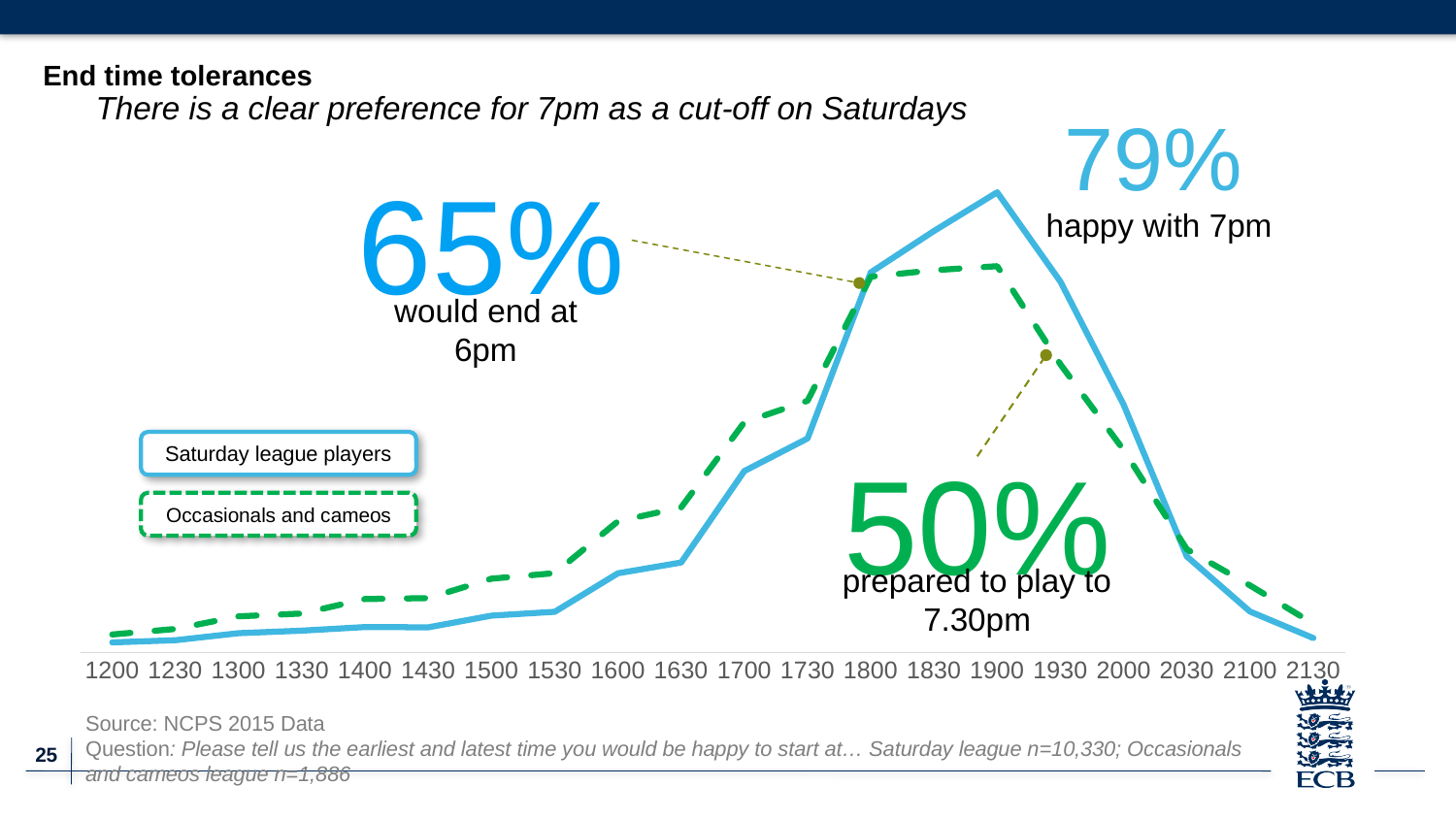
At which time does the Saturday league players line reach its highest point? 1900 According to the callout, what percentage are happy with 7pm? 79% How many percentage points higher is the share happy with 7pm (79%) than the share who would end at 6pm (65%)? 14 percentage points According to the callout, what percentage are prepared to play to 7.30pm? 50% Does the Saturday league players line rise or fall between 1200 and 1900? rise How many series does the legend list? 2 How many time points are shown along the x axis? 20 According to the callout, what percentage would end at 6pm? 65% What are the two series named in the legend? Saturday league players; Occasionals and cameos What kind of chart is shown on the slide? line chart Does the Saturday league players line rise or fall between 1900 and 2130? fall At 1600, which series is higher: Saturday league players or Occasionals and cameos? Occasionals and cameos